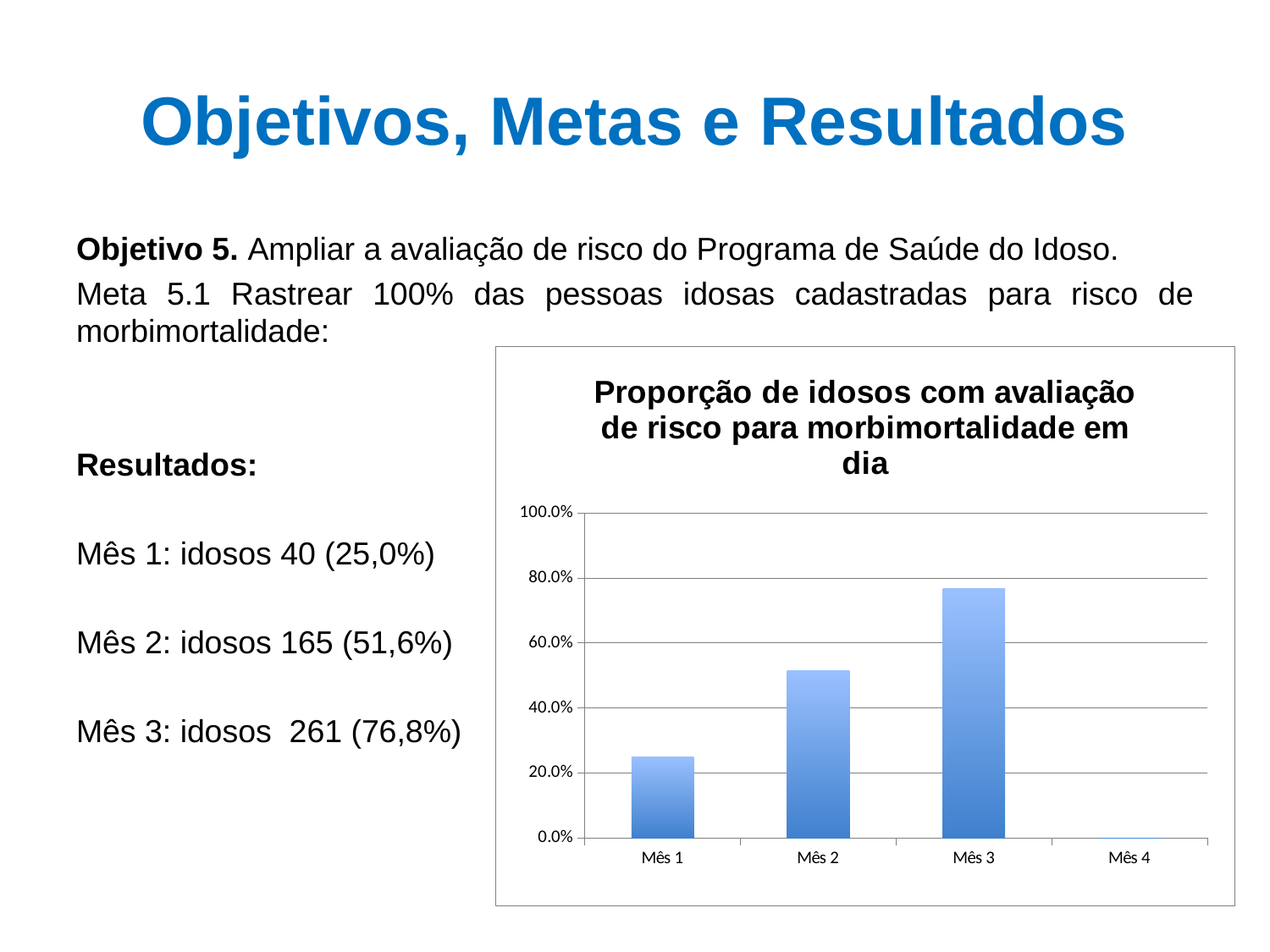
What is the title of the chart? Proporção de idosos com avaliação de risco para morbimortalidade em dia Is the value for Mês 2 greater or less than 60.0%? less Which month has the lowest bar in the chart? Mês 4 Do the values rise or fall from Mês 1 to Mês 3? rise How many categories are shown on the x axis of the chart? 4 Is the value for Mês 3 greater or less than 60.0%? greater According to the results listed on the slide, what proportion of idosos had the risk assessment in Mês 3? 76,8% Which month has the highest bar in the chart? Mês 3 Is the value for Mês 1 greater or less than 20.0%? greater According to the results listed on the slide, what proportion of idosos had the risk assessment in Mês 2? 51,6% Which is larger, the value for Mês 2 or the value for Mês 1? Mês 2 What kind of chart is shown on the slide? bar chart